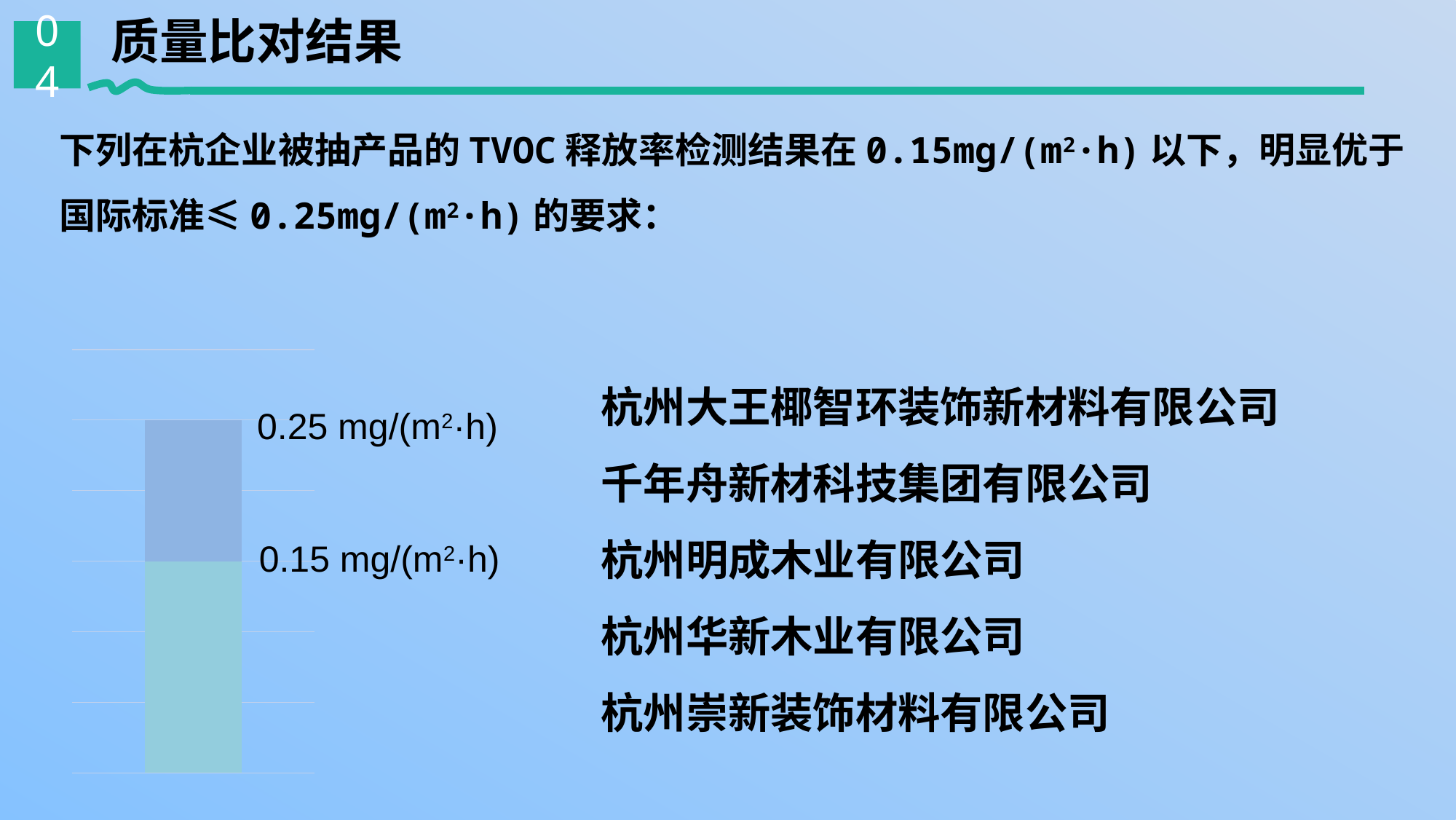
Which of the two labelled values is the lowest? 0.15 mg/(m²·h) Which of the two labelled values is the highest? 0.25 mg/(m²·h) What value is labelled at the top of the upper segment of the bar? 0.25 mg/(m²·h) What is the difference between the two labelled values on the bar, 0.25 mg/(m²·h) and 0.15 mg/(m²·h)? 0.10 mg/(m²·h) How many bars are plotted in the chart? 1 Which labelled value on the bar is larger, 0.25 mg/(m²·h) or 0.15 mg/(m²·h)? 0.25 mg/(m²·h) Does the chart show a legend? No What kind of chart is shown on the slide? bar chart What colour is the lower segment of the bar? teal/green What value is labelled at the top of the lower segment of the bar? 0.15 mg/(m²·h) How many segments does the stacked bar have? 2